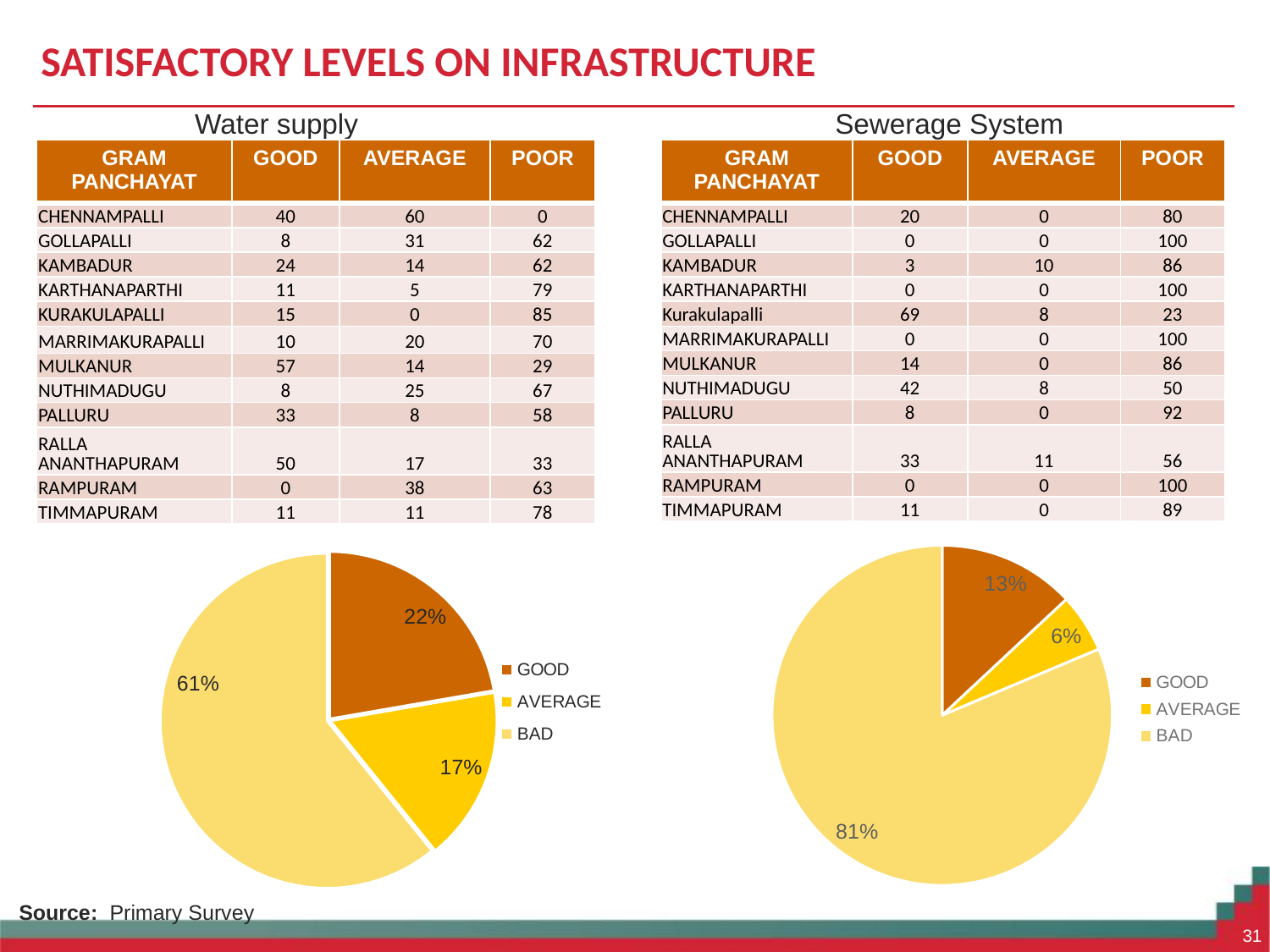
In the right pie chart (below the Sewerage System table), what share is labelled GOOD? 13% In the right pie chart (below the Sewerage System table), which category has the smallest slice? AVERAGE In the left pie chart (below the Water supply table), what share is labelled BAD? 61% In the left pie chart (below the Water supply table), what share is labelled AVERAGE? 17% In the left pie chart (below the Water supply table), which category has the largest slice? BAD In the right pie chart (below the Sewerage System table), what share is labelled BAD? 81% How many categories does the legend of the right pie chart (below the Sewerage System table) list? 3 What type of chart is shown below the Water supply table? Pie chart In the left pie chart (below the Water supply table), what is the difference between the GOOD and AVERAGE shares? 5% Which is larger: the BAD share in the left pie chart or the BAD share in the right pie chart? The right pie chart (81%) In the left pie chart (below the Water supply table), what share is labelled GOOD? 22% In the right pie chart (below the Sewerage System table), what share is labelled AVERAGE? 6%